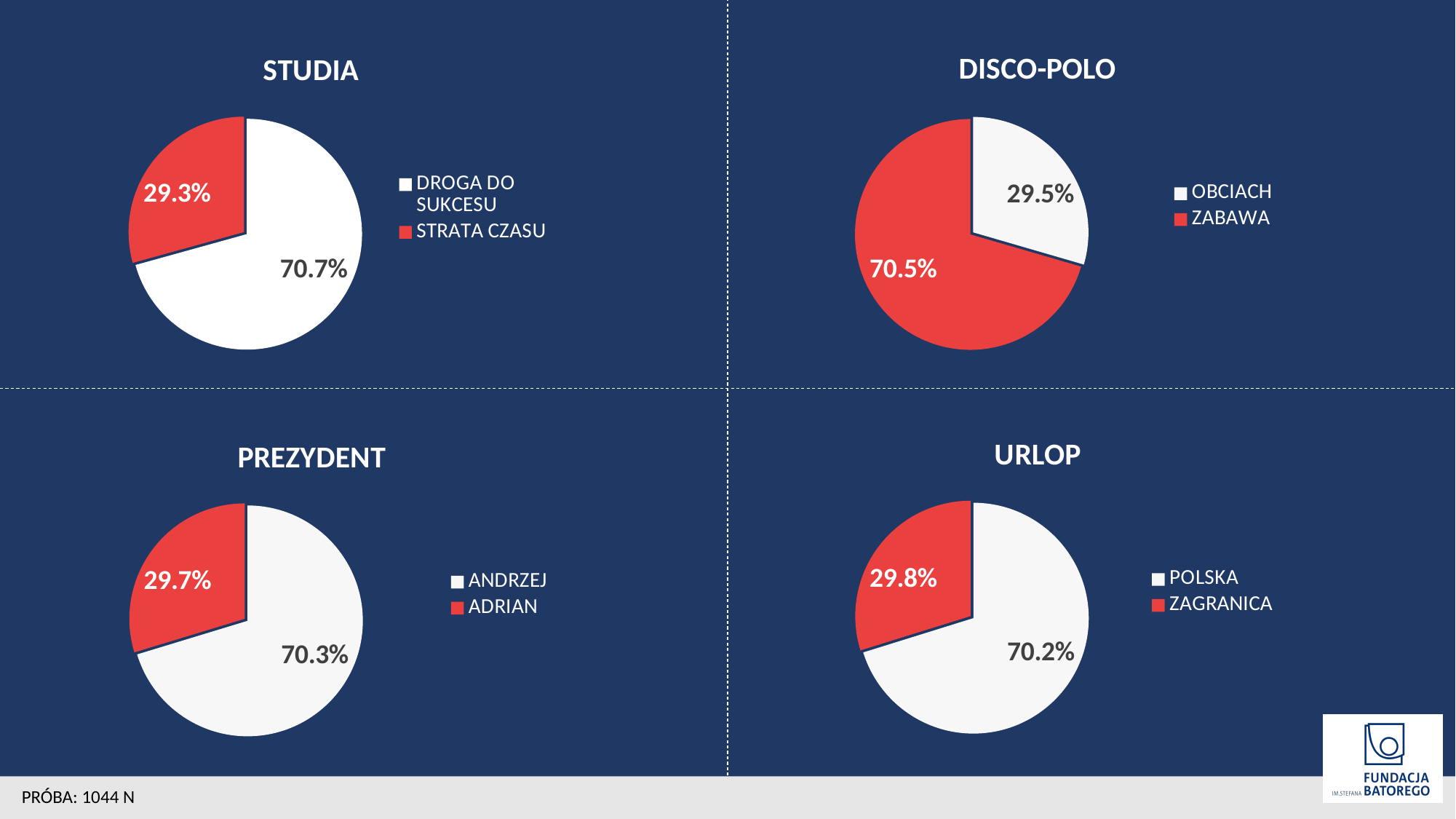
In the STUDIA chart, which is larger, DROGA DO SUKCESU or STRATA CZASU? DROGA DO SUKCESU In the PREZYDENT chart, which slice is the largest? ANDRZEJ In the DISCO-POLO chart, what share is labelled for OBCIACH? 29.5% How many entries does the legend of the PREZYDENT chart list? 2 In the DISCO-POLO chart, what share is labelled for ZABAWA? 70.5% In the URLOP chart, what is the difference between the POLSKA and ZAGRANICA shares? 40.4% In the STUDIA chart, what share is labelled for STRATA CZASU? 29.3% In the PREZYDENT chart, what share is labelled for ADRIAN? 29.7% In the STUDIA chart, what share is labelled for DROGA DO SUKCESU? 70.7% What kind of chart is the URLOP chart? Pie chart In the URLOP chart, what share is labelled for POLSKA? 70.2% In the DISCO-POLO chart, which slice is the smallest? OBCIACH